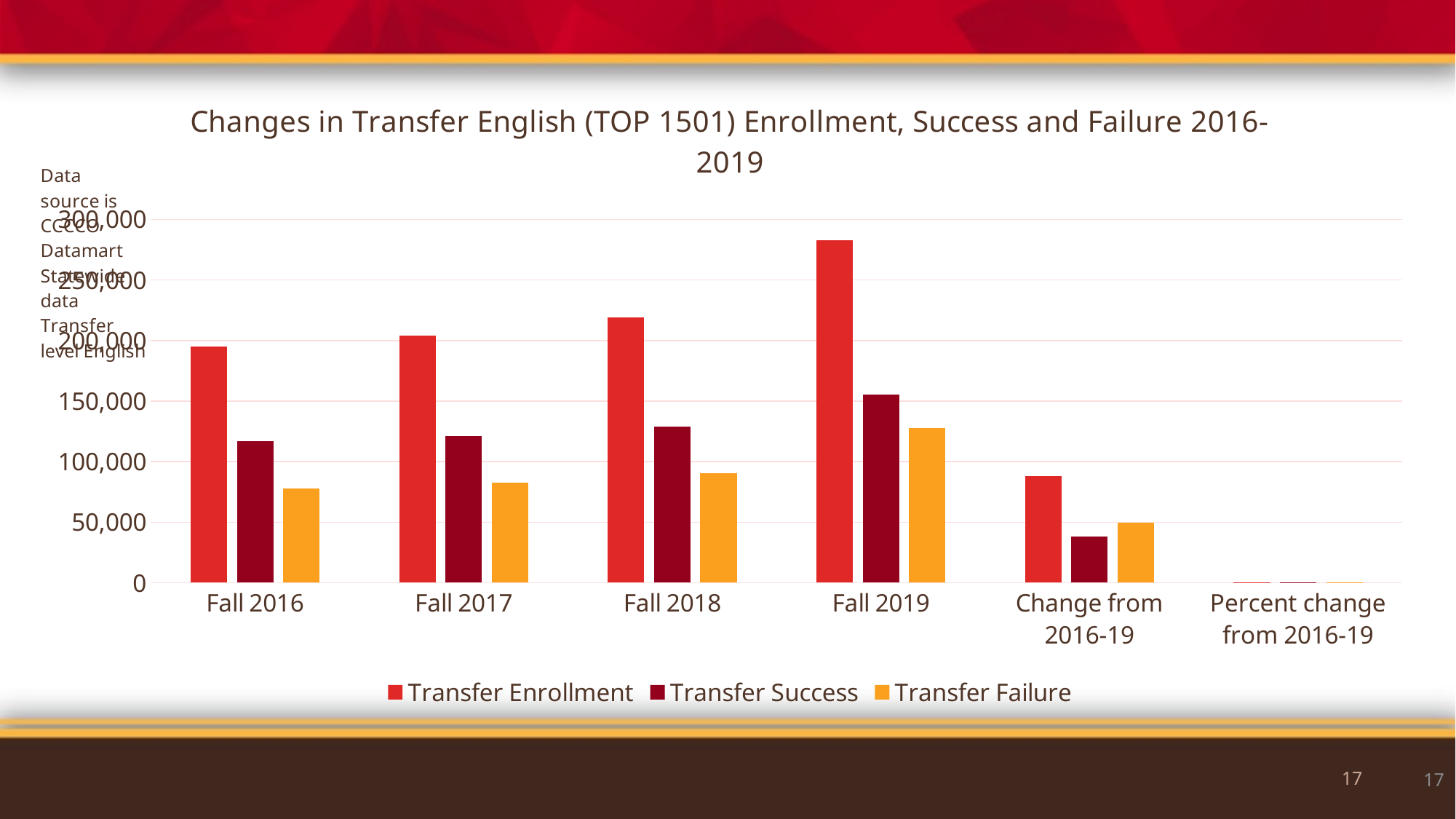
Which category has the highest Transfer Enrollment bar? Fall 2019 Is the Transfer Failure value for Fall 2018 greater or less than 100,000? less What kind of chart is shown on the slide? bar chart Is the Transfer Enrollment value for Fall 2016 greater or less than 200,000? less Which is larger for Fall 2017: Transfer Success or Transfer Failure? Transfer Success Is the Transfer Enrollment value for Fall 2019 greater or less than 250,000? greater How many categories are shown on the x axis? 6 How many series does the legend list? 3 Does Transfer Enrollment rise or fall from Fall 2016 to Fall 2019? rise Which series is shown in orange in the legend? Transfer Failure Among the Fall 2016 to Fall 2019 categories, which has the lowest Transfer Enrollment bar? Fall 2016